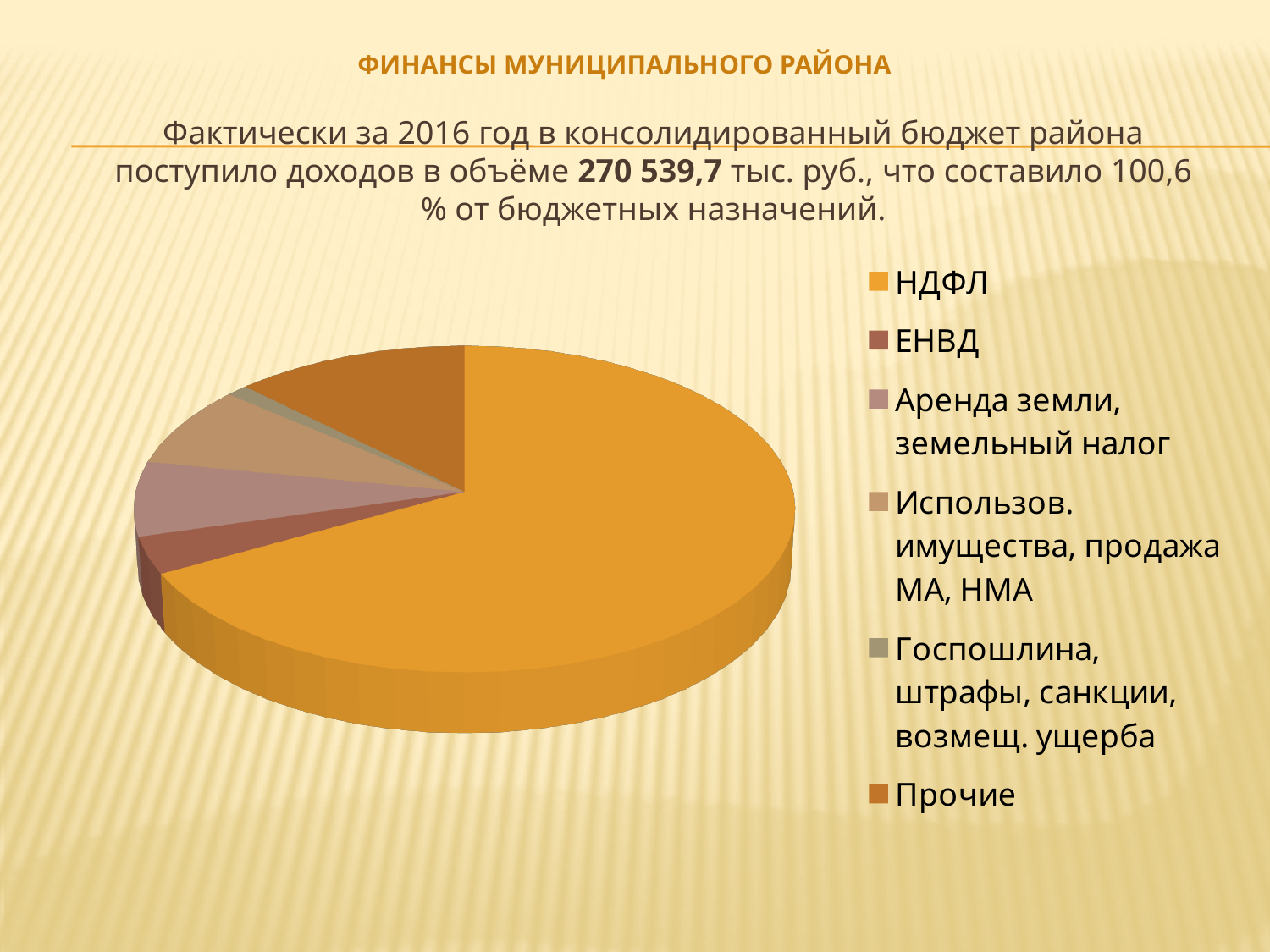
How many categories does the pie chart's legend list? 6 Which legend entry is listed last in the pie chart's legend? Прочие Which category has the smallest slice of the pie chart? Госпошлина, штрафы, санкции, возмещ. ущерба Does the largest slice of the pie chart account for more or less than half of the pie? more What kind of chart is shown on the slide? pie chart Which slice is larger in the pie chart: Прочие or Госпошлина, штрафы, санкции, возмещ. ущерба? Прочие Which legend entry is listed first in the pie chart's legend? НДФЛ Which category has the largest slice of the pie chart? НДФЛ Which slice is larger in the pie chart: НДФЛ or Использов. имущества, продажа МА, НМА? НДФЛ Which slice is larger in the pie chart: Аренда земли, земельный налог or ЕНВД? Аренда земли, земельный налог